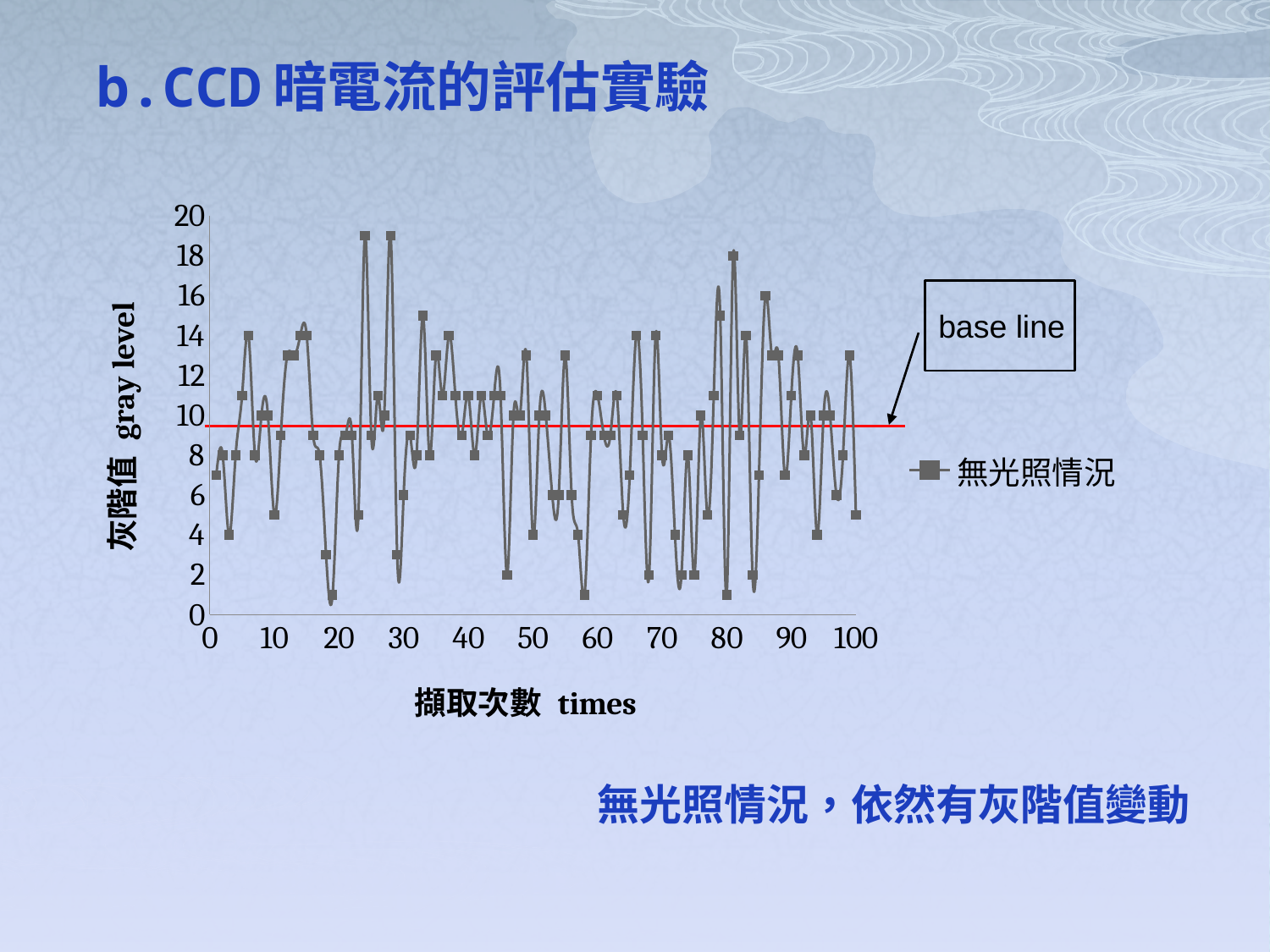
Is the value at x = 58 greater or less than 2? less Is the value at x = 80 greater or less than 2? less What does the red horizontal line across the chart represent, according to the label on the slide? base line Is the value at x = 24 greater or less than 18? greater What is the name of the series shown in the legend? 無光照情況 How many data series does the legend list? 1 Do the values show a steady rise, a steady fall, or fluctuate along the x axis? fluctuate What kind of chart is shown on the slide? line chart